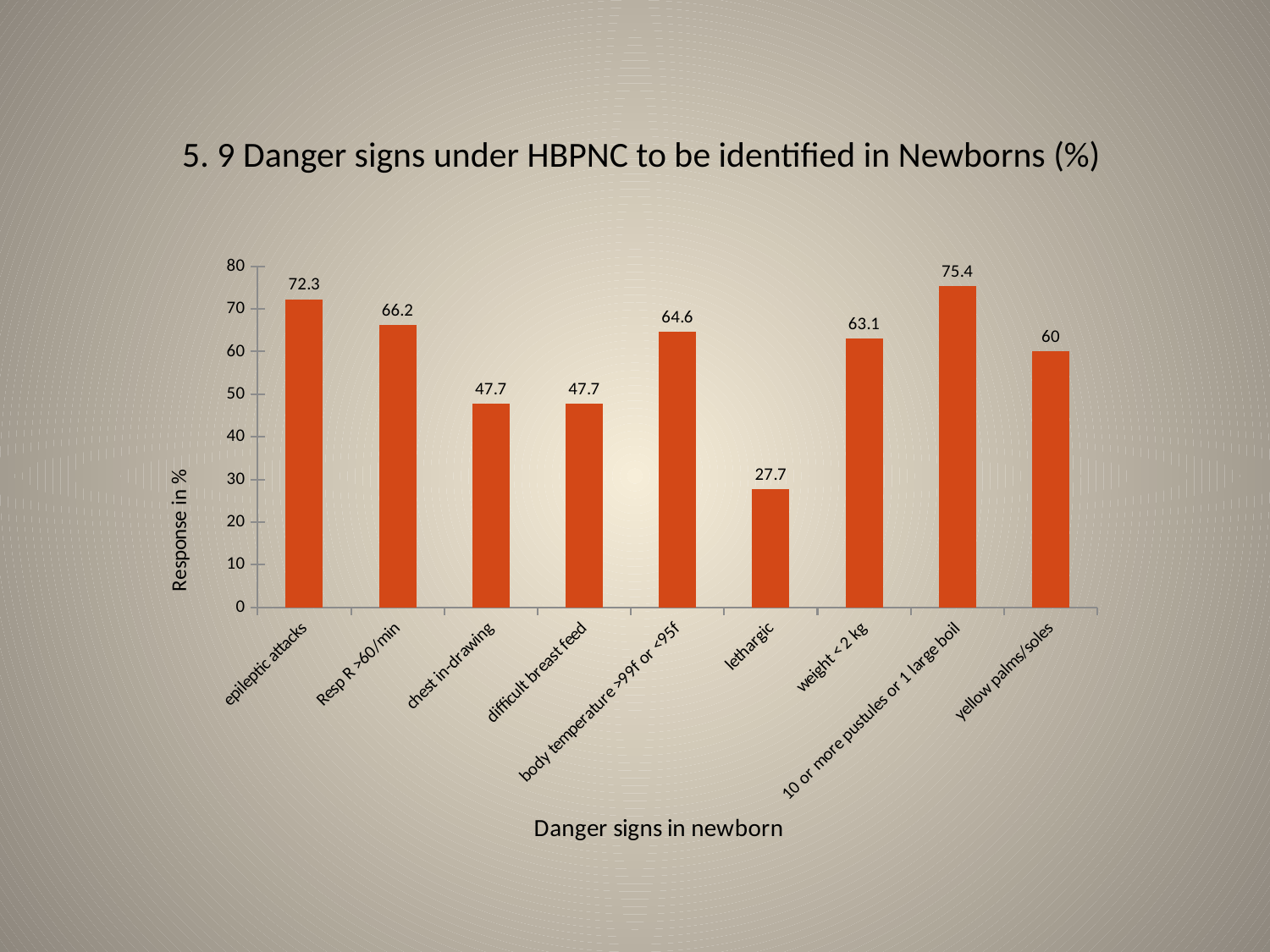
What is the response percentage for epileptic attacks? 72.3 How many danger signs are shown on the x axis? 9 What is the difference between the values for epileptic attacks and lethargic? 44.6 Is the value for body temperature >99f or <95f greater or less than 60? greater Which danger sign has the lowest response percentage? lethargic What is the value shown for lethargic? 27.7 What is the label of the y axis? Response in % Which danger sign has the highest response percentage? 10 or more pustules or 1 large boil What is the value for 10 or more pustules or 1 large boil? 75.4 What is the value for yellow palms/soles? 60 Which is larger, the value for Resp R >60/min or the value for weight < 2 kg? Resp R >60/min What kind of chart is shown on the slide? bar chart